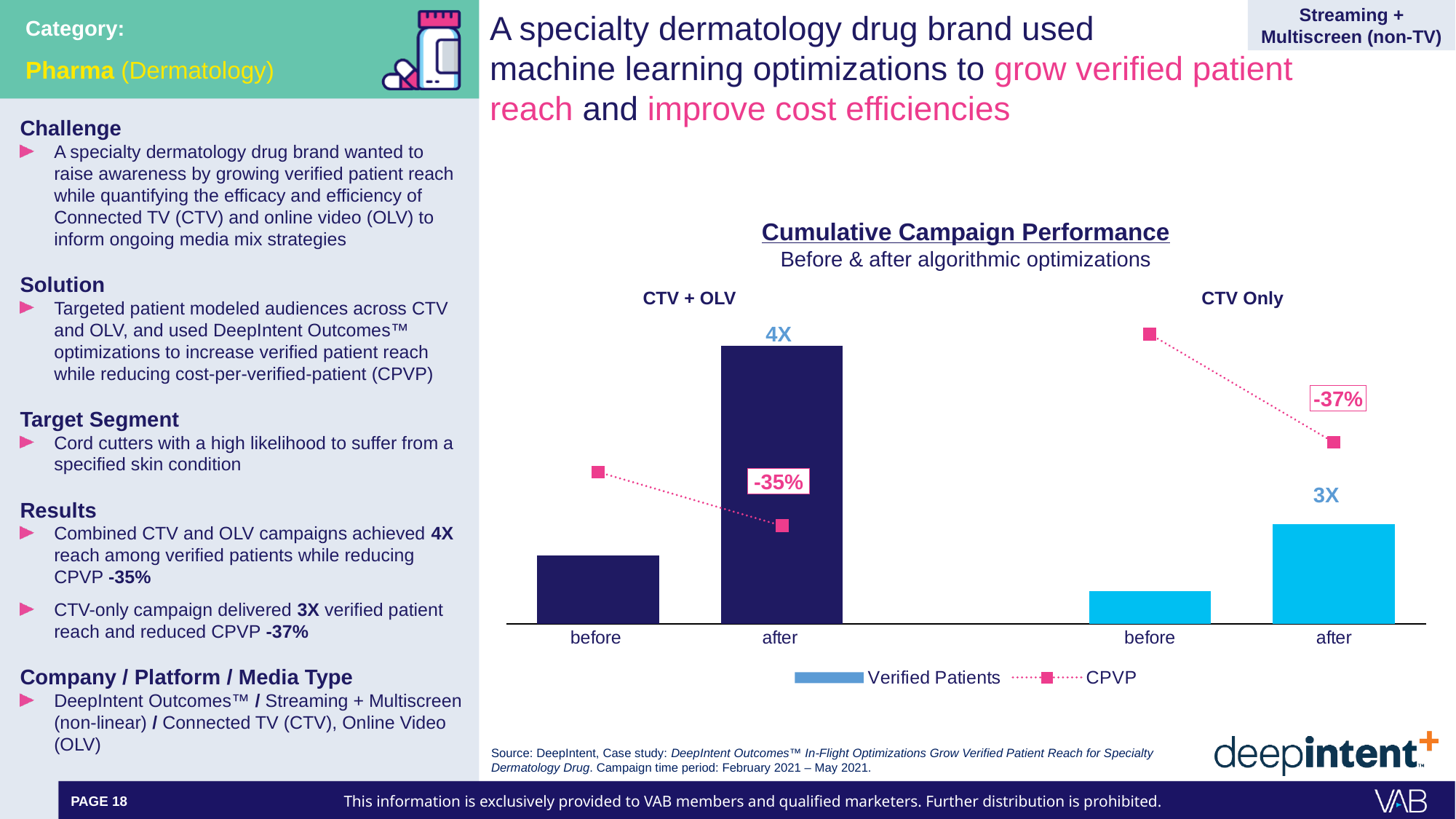
What kind of chart is used to show Verified Patients? bar chart What label is shown above the 'after' Verified Patients bar in the CTV Only group? 3X What is the subtitle shown under the chart title? Before & after algorithmic optimizations In the CTV Only group, does the CPVP line rise or fall from 'before' to 'after'? fall How many Verified Patients bars are plotted in total on the chart? 4 What label is shown above the 'after' Verified Patients bar in the CTV + OLV group? 4X How many series does the legend list? 2 Which group shows the larger reach multiplier label, CTV + OLV or CTV Only? CTV + OLV What is the title of the chart? Cumulative Campaign Performance In the CTV + OLV group, which Verified Patients bar is taller, 'before' or 'after'? after What percentage change in CPVP is shown for the CTV + OLV group? -35% What percentage change in CPVP is shown for the CTV Only group? -37%